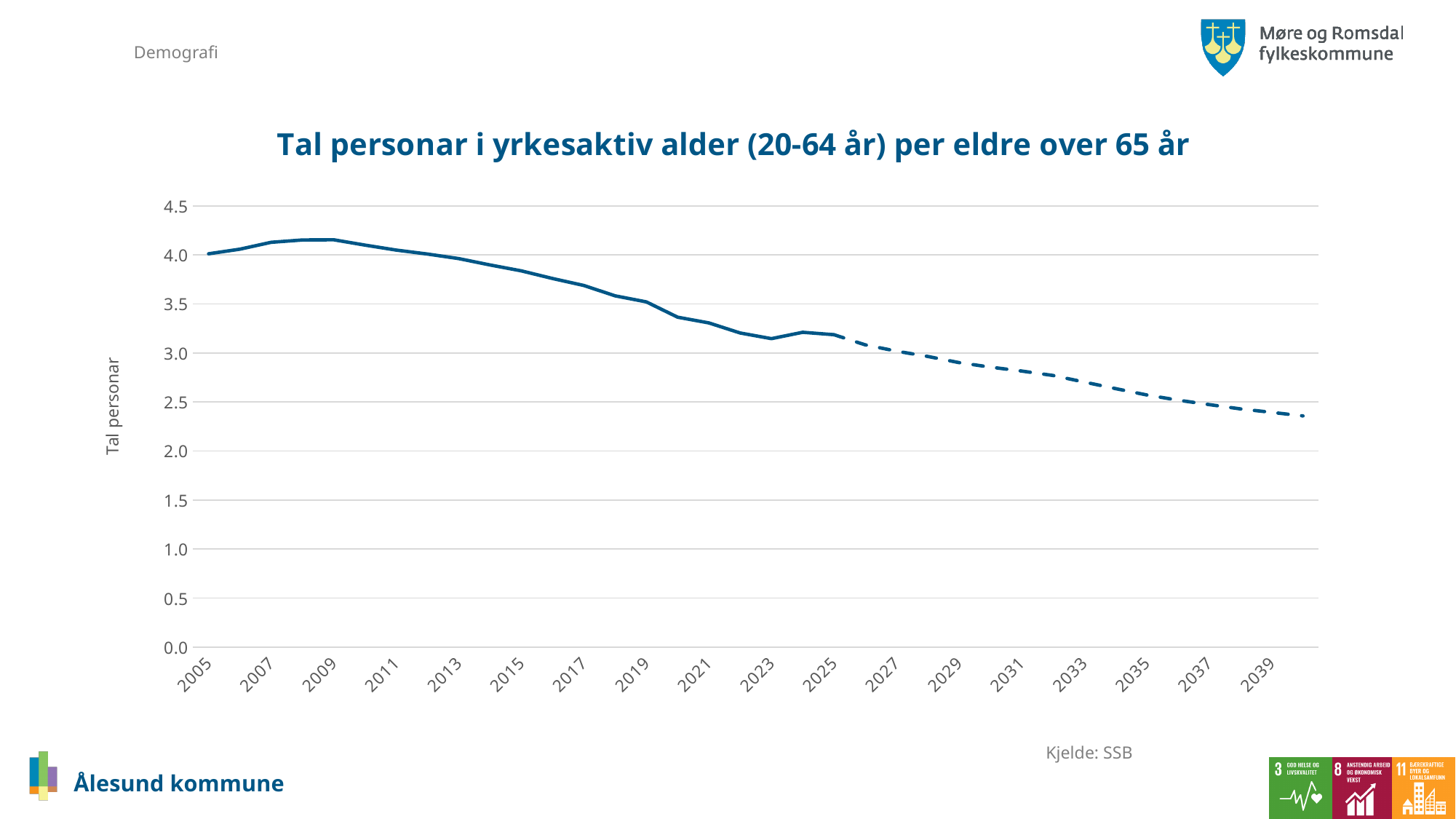
Is the value for 2025 greater or less than 3.5? less Is the value for 2009 greater or less than 4.0? greater Which is larger, the value for 2005 or the value for 2023? 2005 Is the value for 2015 greater or less than 4.0? less What kind of chart is shown on the slide? line chart What is the label on the y axis of the chart? Tal personar What is the title of the chart? Tal personar i yrkesaktiv alder (20-64 år) per eldre over 65 år Does the line generally rise or fall from 2009 to 2039? fall